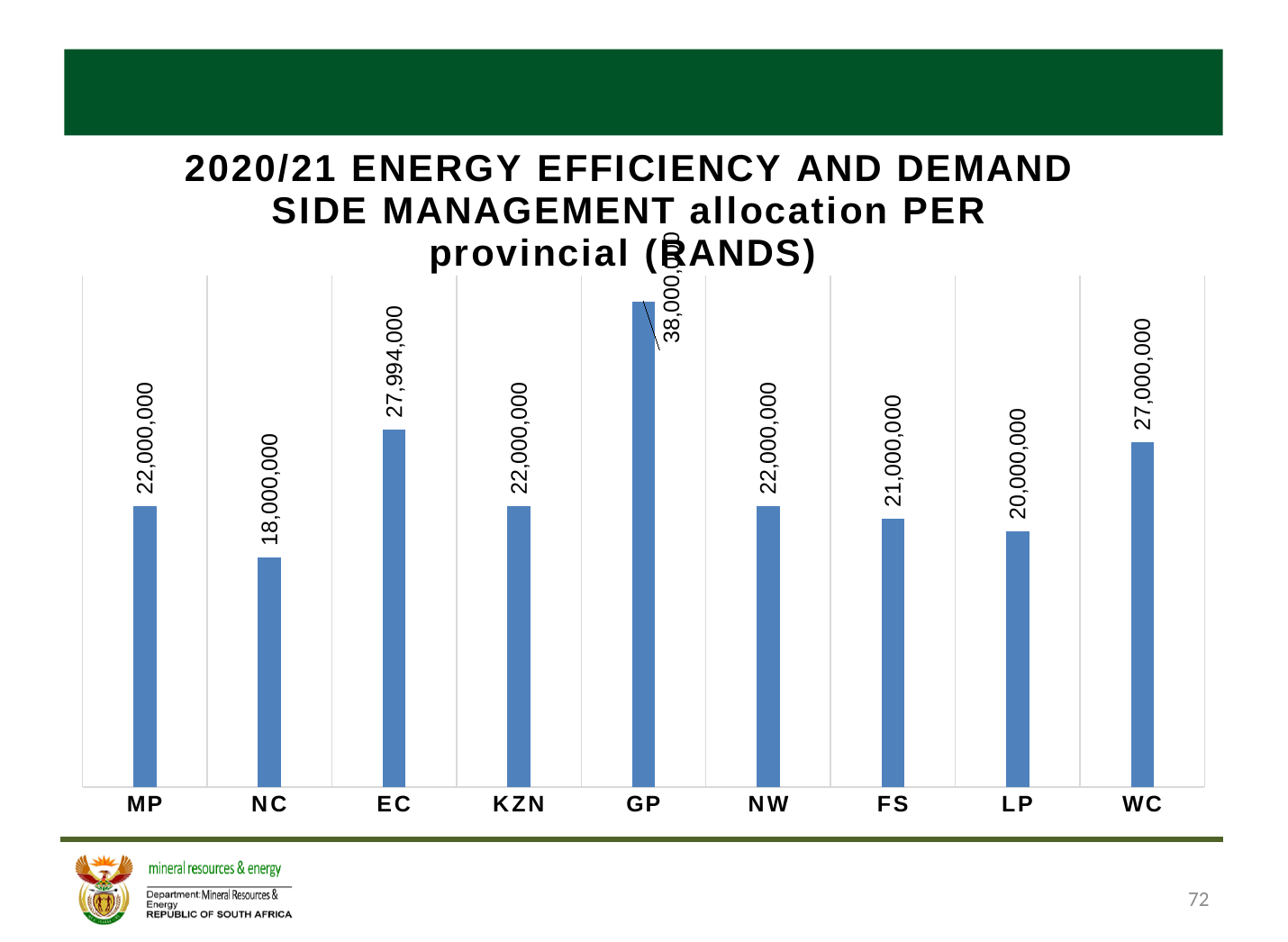
How many provinces are shown on the chart? 9 What is the allocation for EC? 27,994,000 What is the allocation for MP? 22,000,000 What is the difference between the allocations for MP and NC? 4,000,000 Which has a larger allocation, FS or LP? FS Which province has the highest allocation? GP What is the allocation for NC? 18,000,000 Which province has the lowest allocation? NC What is the allocation for WC? 27,000,000 What is the difference between the allocations for EC and WC? 994,000 What is the allocation for LP? 20,000,000 What kind of chart is shown on the slide? Bar chart